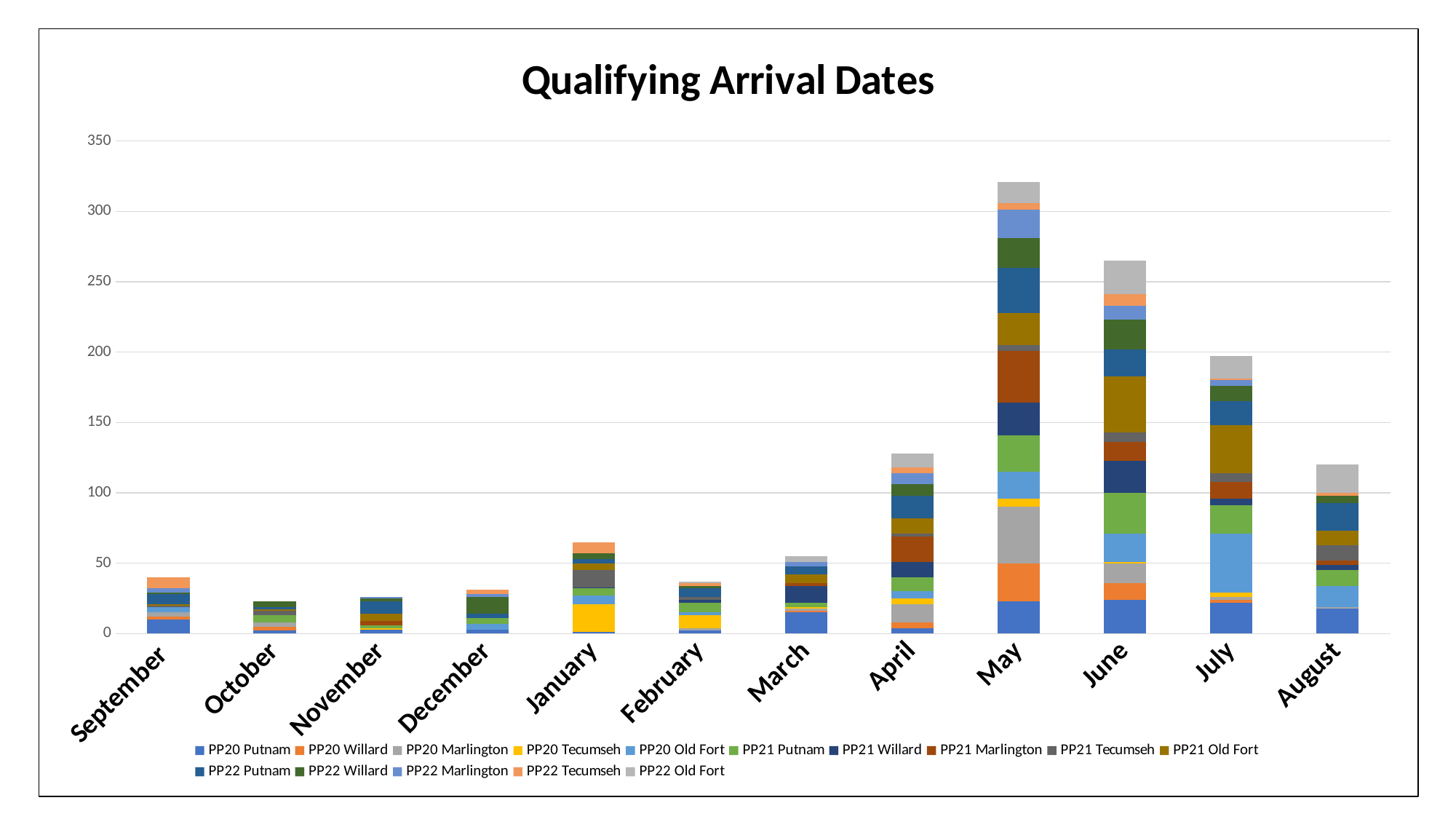
Is the total for May greater or less than 300? greater Which month has the larger total bar, May or June? May How many months are shown along the x axis? 12 How many series does the legend list? 15 Which month has the highest total bar? May What is the title of the chart? Qualifying Arrival Dates From May to August, do the total bar heights rise or fall? fall Which month has the larger total bar, January or February? January Is the total for June greater or less than 250? greater Is the total for September greater or less than 50? less What kind of chart is shown on the slide? Stacked bar chart